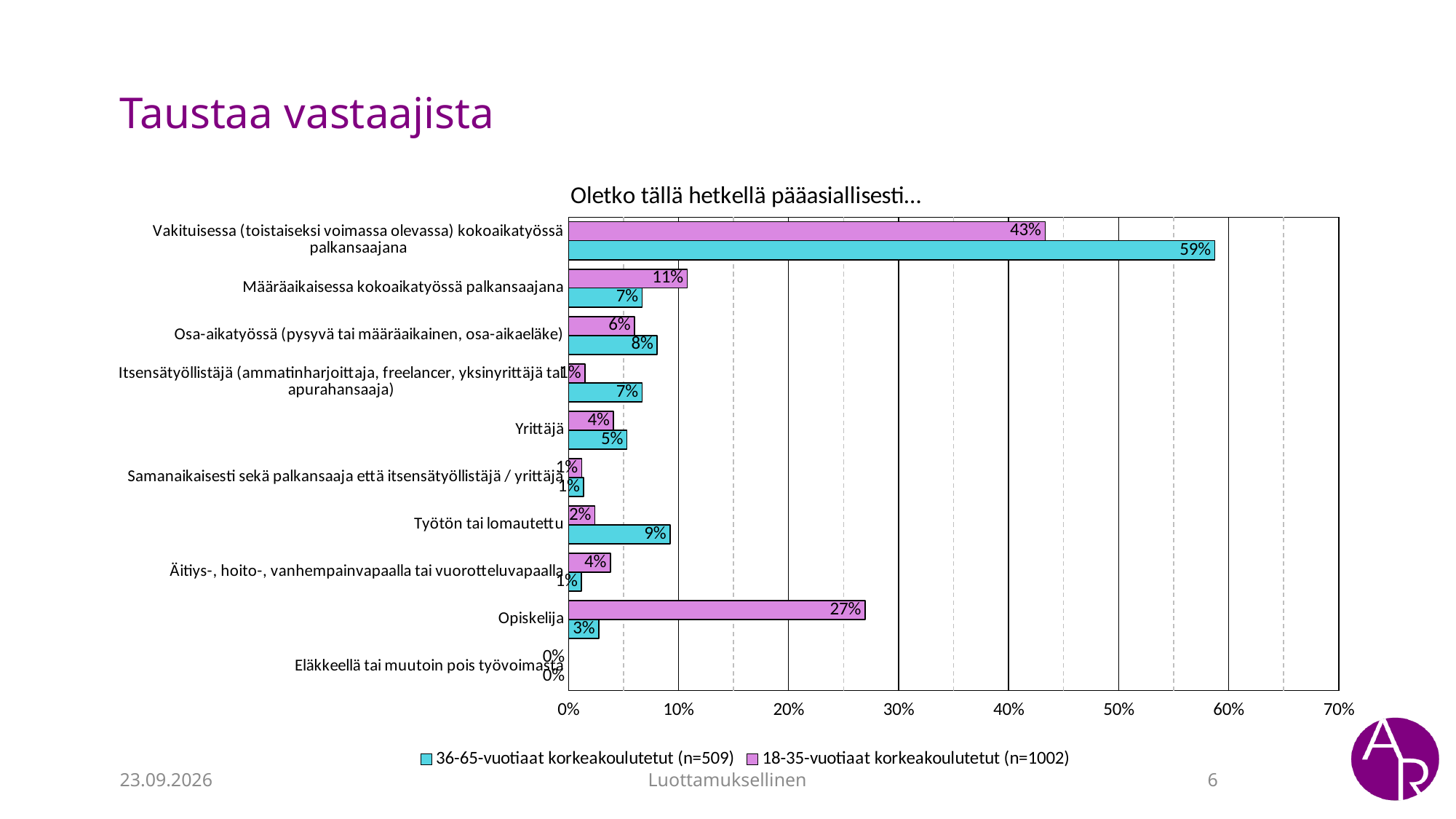
How many categories are shown on the chart? 10 What is the value for 'Vakituisessa (toistaiseksi voimassa olevassa) kokoaikatyössä palkansaajana' for the 36-65-vuotiaat korkeakoulutetut (n=509) series? 59% What is the difference between the two series for 'Opiskelija'? 24% What kind of chart is shown on the slide? bar chart How many series does the legend list? 2 For 'Määräaikaisessa kokoaikatyössä palkansaajana', which series has the larger value? 18-35-vuotiaat korkeakoulutetut (n=1002) What is the title of the chart? Oletko tällä hetkellä pääasiallisesti… Which category has the lowest value for the 36-65-vuotiaat korkeakoulutetut (n=509) series? Eläkkeellä tai muutoin pois työvoimasta Which category has the highest value for the 18-35-vuotiaat korkeakoulutetut (n=1002) series? Vakituisessa (toistaiseksi voimassa olevassa) kokoaikatyössä palkansaajana What is the value for 'Opiskelija' for the 18-35-vuotiaat korkeakoulutetut (n=1002) series? 27% What is the value for 'Työtön tai lomautettu' for the 36-65-vuotiaat korkeakoulutetut (n=509) series? 9% What is the difference between the two series for 'Vakituisessa (toistaiseksi voimassa olevassa) kokoaikatyössä palkansaajana'? 16%